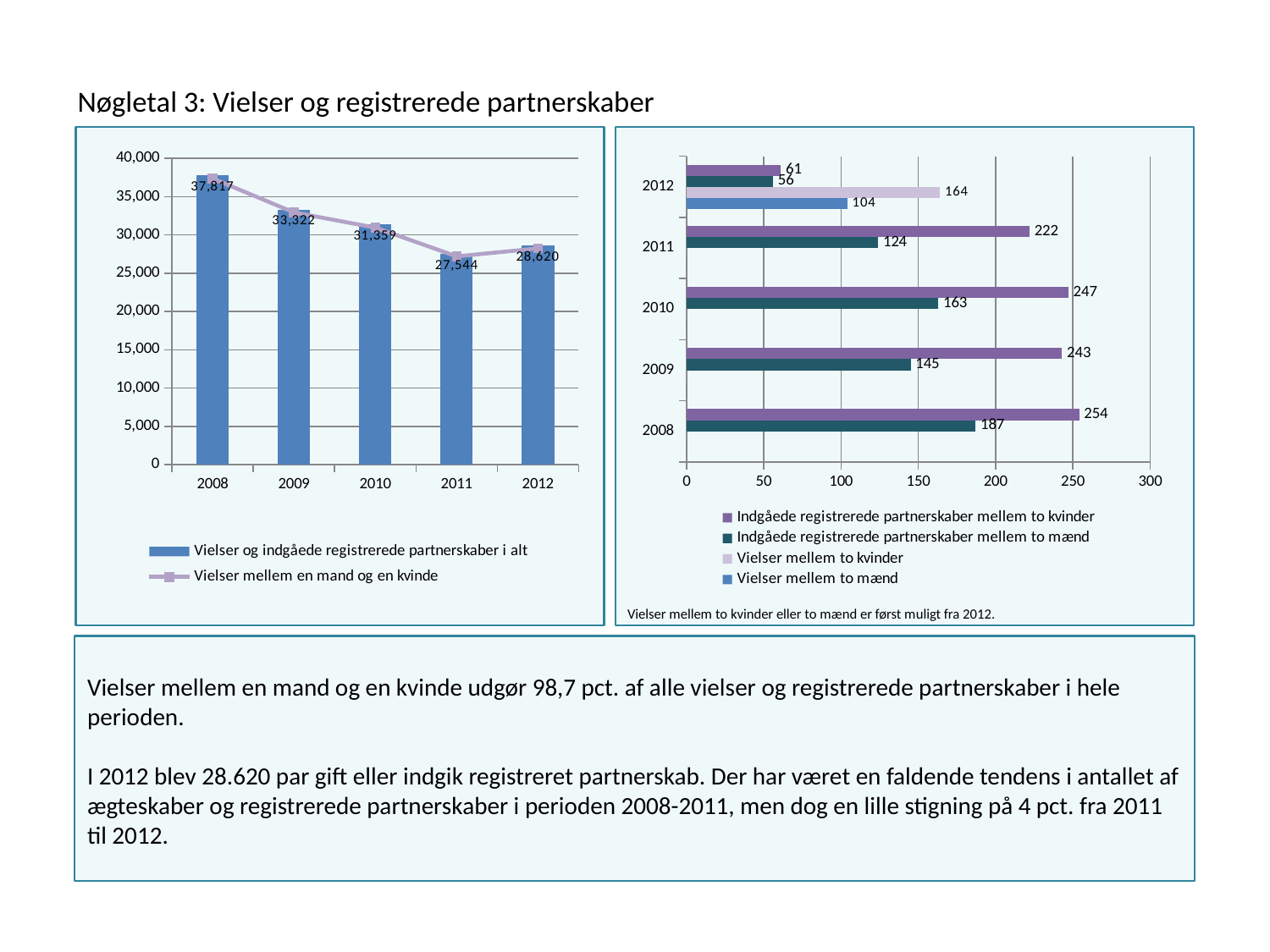
In the left chart, what value is labelled for 2011? 27,544 In the right chart, what is the value for 'Indgåede registrerede partnerskaber mellem to mænd' in 2008? 187 In the right chart, which year has the highest value for 'Indgåede registrerede partnerskaber mellem to kvinder'? 2008 In the right chart, what is the difference between 'Vielser mellem to kvinder' and 'Vielser mellem to mænd' in 2012? 60 How many series does the legend of the right chart list? 4 In the left chart, which year has the lowest labelled value? 2011 In the left chart, what is the difference between the labelled values for 2008 and 2012? 9,197 How many years are shown on the x axis of the left chart? 5 What kind of chart is the left chart on the slide? combination bar and line chart In the left chart, what value is labelled for 2008? 37,817 In the left chart, do the values rise or fall from 2008 to 2011? fall In the right chart, what is the value for 'Indgåede registrerede partnerskaber mellem to kvinder' in 2010? 247